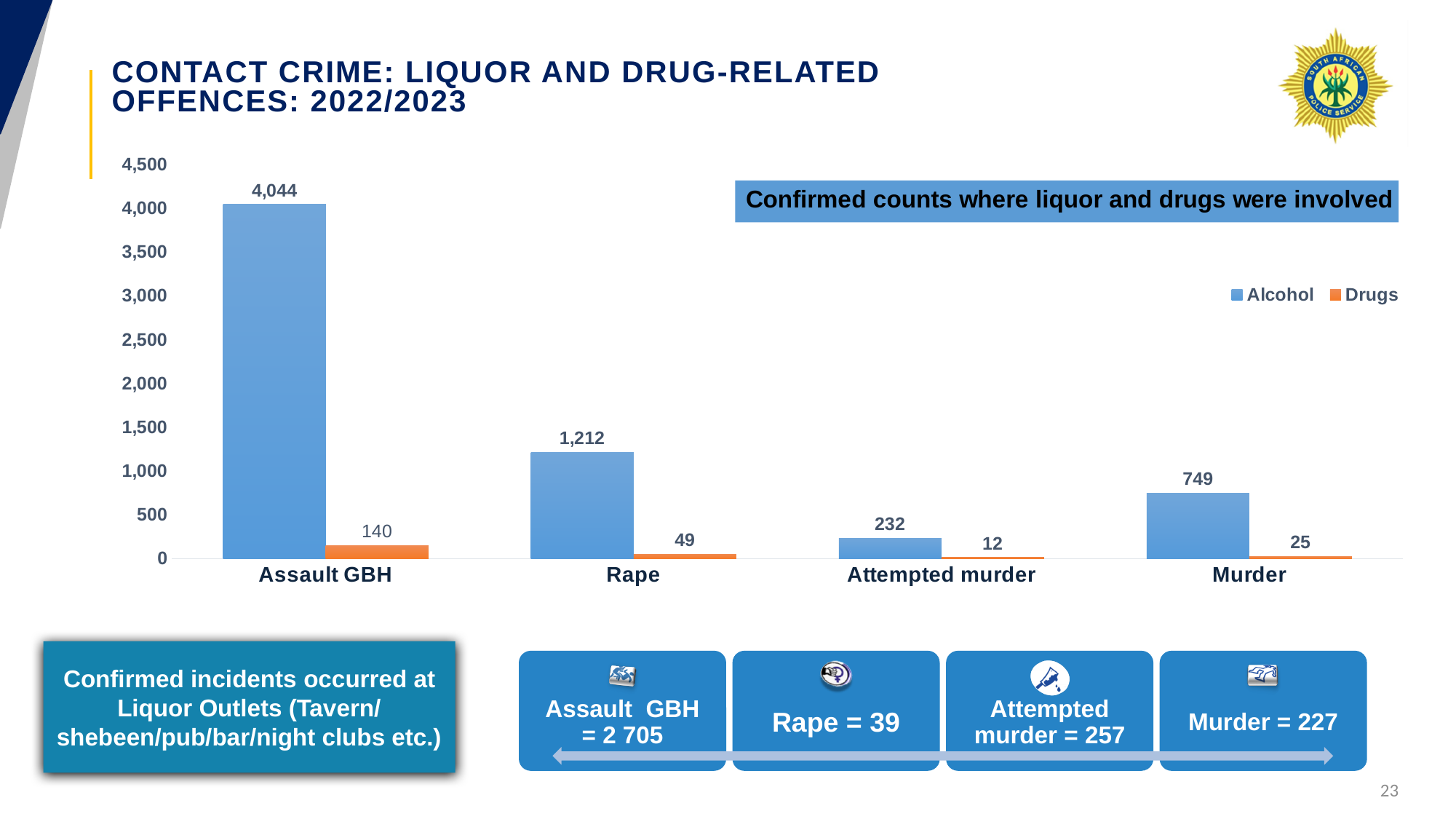
Is the Alcohol value for Rape greater or less than 1,000? greater What is the difference between the Alcohol and Drugs values for Rape? 1,163 What kind of chart is shown on the slide? bar chart What is the Drugs value for Attempted murder? 12 Which category has the lowest Drugs value? Attempted murder Which category has the highest Alcohol value? Assault GBH What is the Alcohol value for Murder? 749 What is the Alcohol value for Assault GBH? 4,044 What is the Drugs value for Rape? 49 How many categories are shown on the x axis? 4 How many series does the legend list? 2 Which is larger, the Alcohol value for Murder or the Alcohol value for Attempted murder? Murder